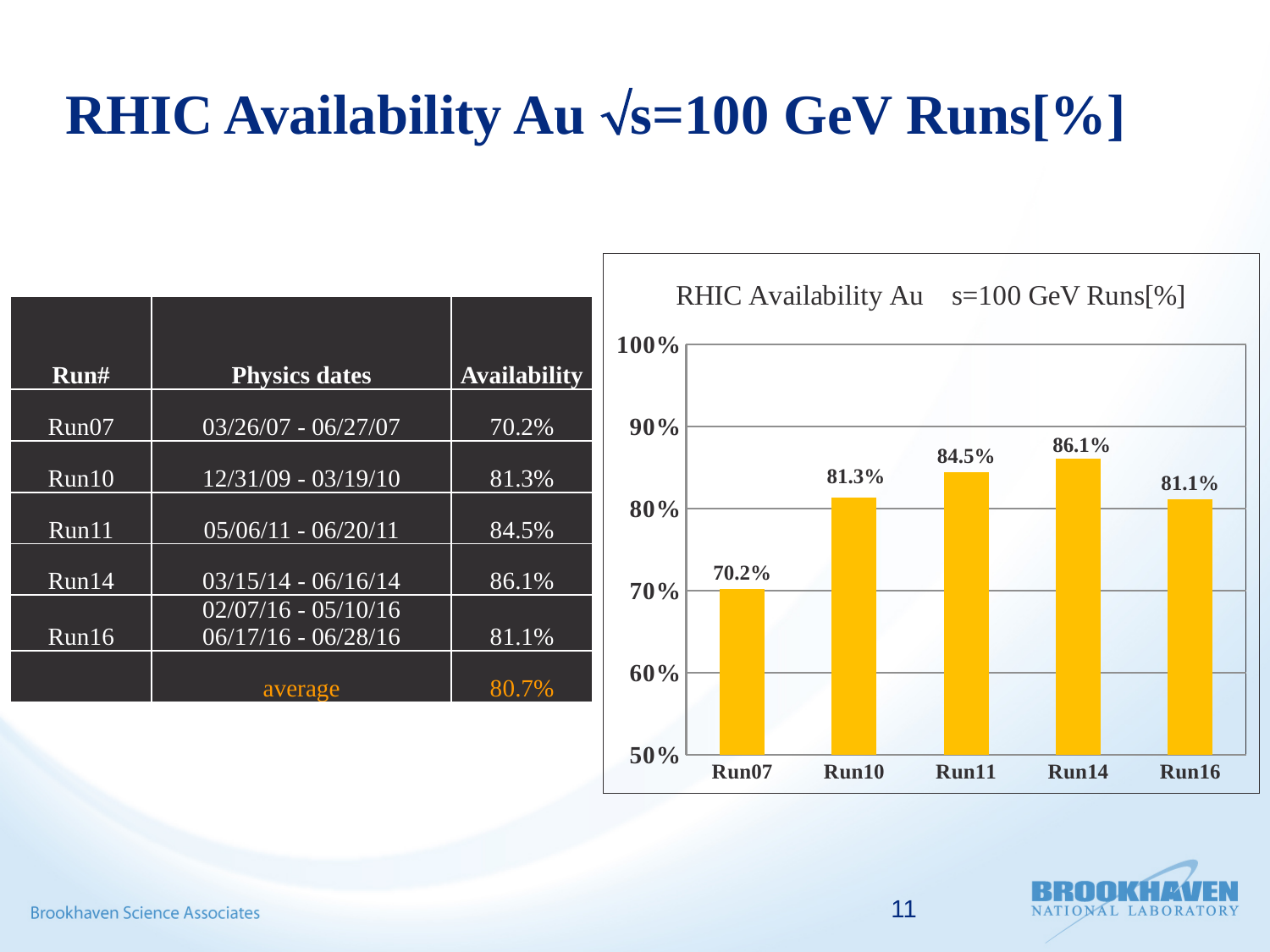
What colour are the bars in the chart? yellow What type of chart is shown on the slide? bar chart What is the difference in availability between Run11 and Run10? 3.2% How many runs are plotted in the chart? 5 Is the availability for Run07 greater or less than 80%? less Which has a higher availability, Run10 or Run11? Run11 What is the availability value shown for Run16 in the chart? 81.1% Which run has the highest availability in the chart? Run14 What is the difference in availability between Run14 and Run07? 15.9% What is the availability value shown for Run14 in the chart? 86.1% What is the availability value shown for Run07 in the chart? 70.2% Which run has the lowest availability in the chart? Run07